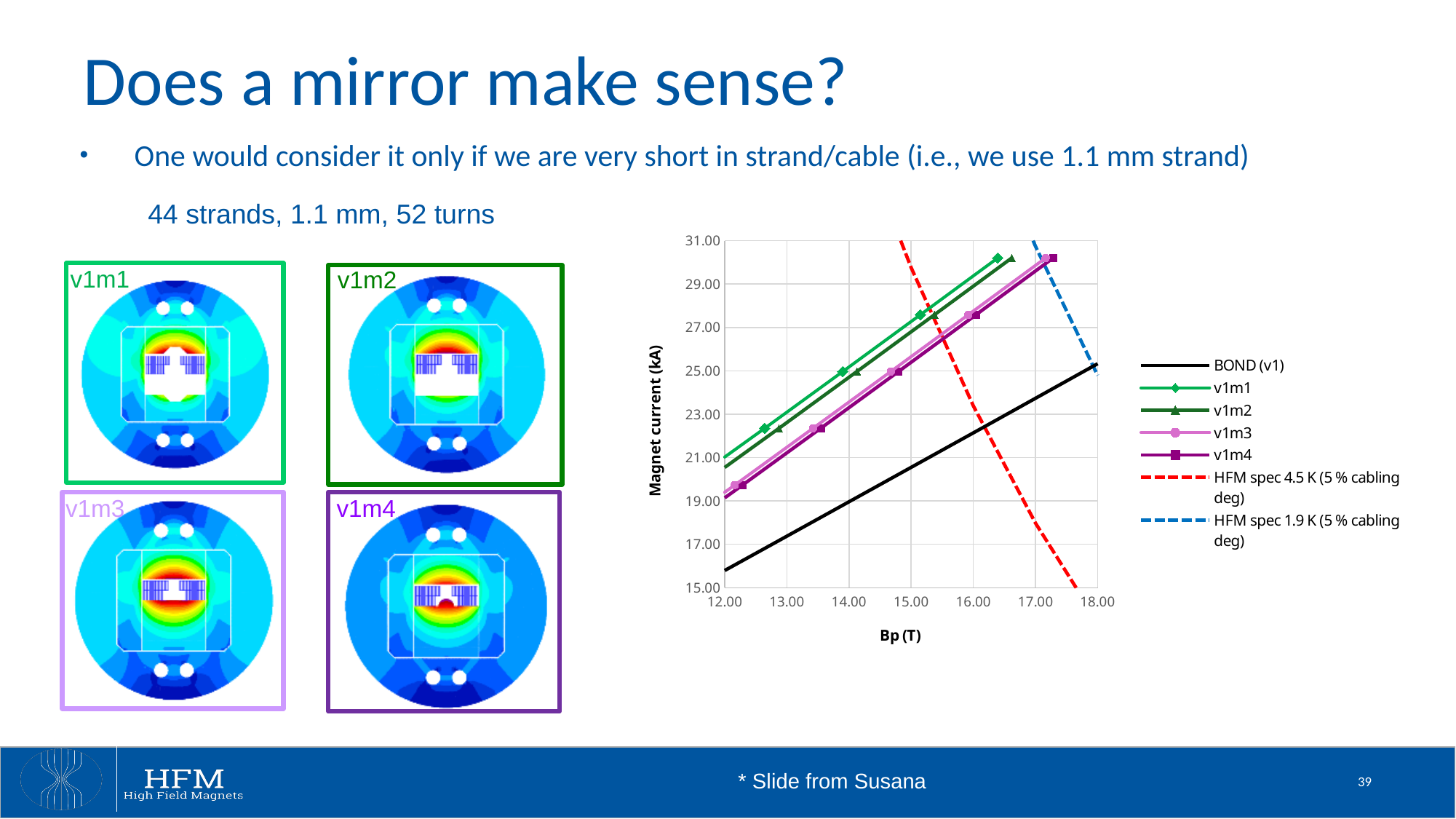
Is the magnet current of BOND (v1) at Bp = 12.00 T greater or less than 17.00 kA? less What kind of chart is shown on the right of the slide? Line chart What is the label of the y axis of the chart? Magnet current (kA) At Bp = 13.00 T, which series has the higher magnet current, v1m1 or v1m3? v1m1 What is the label of the x axis of the chart? Bp (T) How many series does the chart legend list? 7 Does the HFM spec 4.5 K (5 % cabling deg) dashed line rise or fall as Bp increases? Falls Which series has the lowest magnet current at Bp = 12.00 T? BOND (v1) Does the v1m1 series rise or fall as Bp increases? Rises Is the magnet current of v1m1 at Bp = 14.00 T greater or less than 23.00 kA? greater Is the magnet current of v1m4 at Bp = 12.00 T greater or less than 21.00 kA? less At Bp = 14.00 T, which series has the higher magnet current, v1m1 or BOND (v1)? v1m1